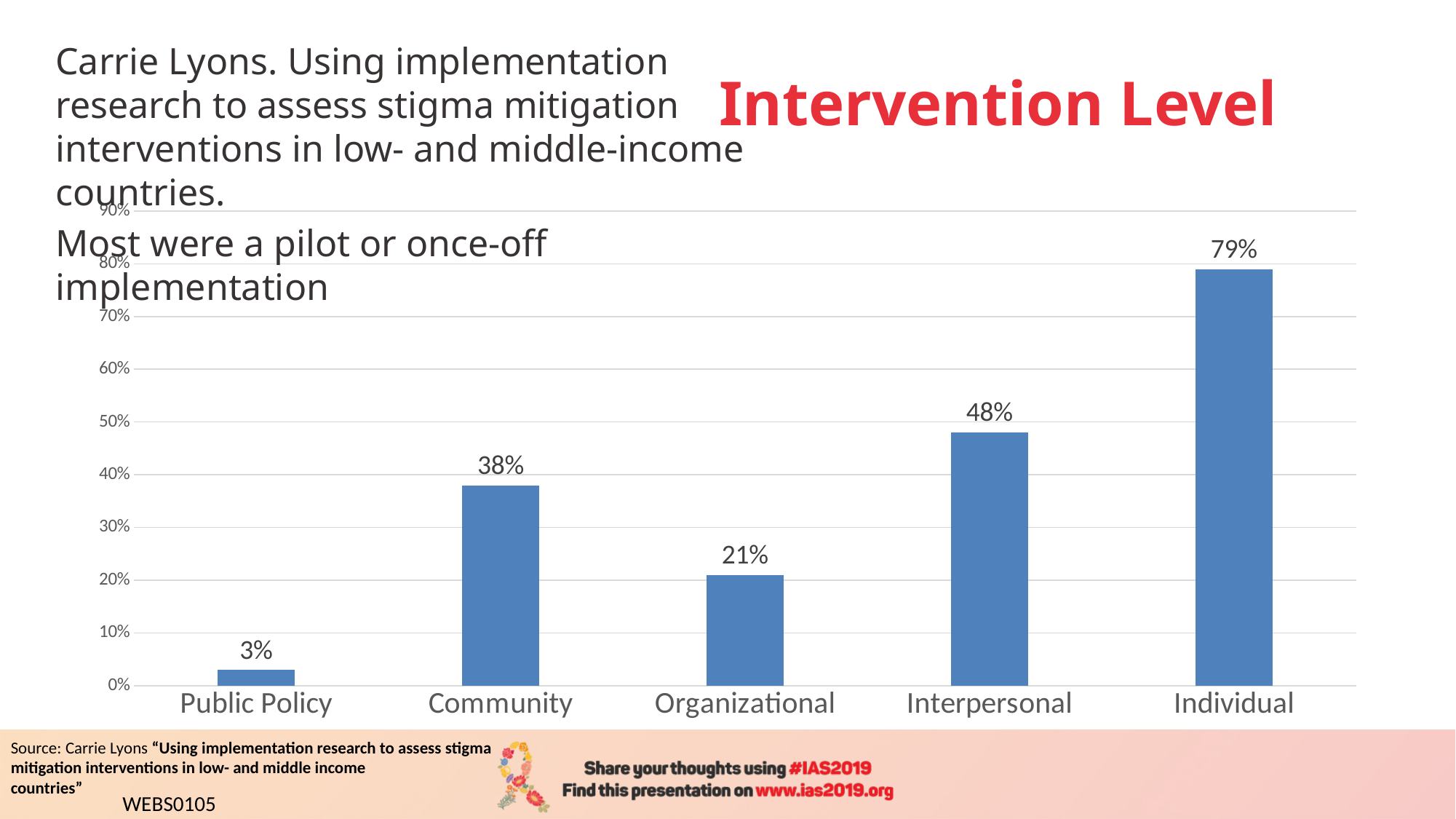
What kind of chart is shown on the slide? bar chart Which intervention level has the lowest value? Public Policy Which intervention level has the highest value? Individual What is the title of the chart? Intervention Level What is the value for Organizational? 21% Is the value for Interpersonal greater or less than 40%? greater Which is larger, the value for Community or the value for Interpersonal? Interpersonal What is the difference between the values for Community and Organizational? 17% What is the value for Individual? 79% What is the difference between the values for Individual and Interpersonal? 31% What is the value for Public Policy? 3% How many intervention levels are shown on the chart? 5